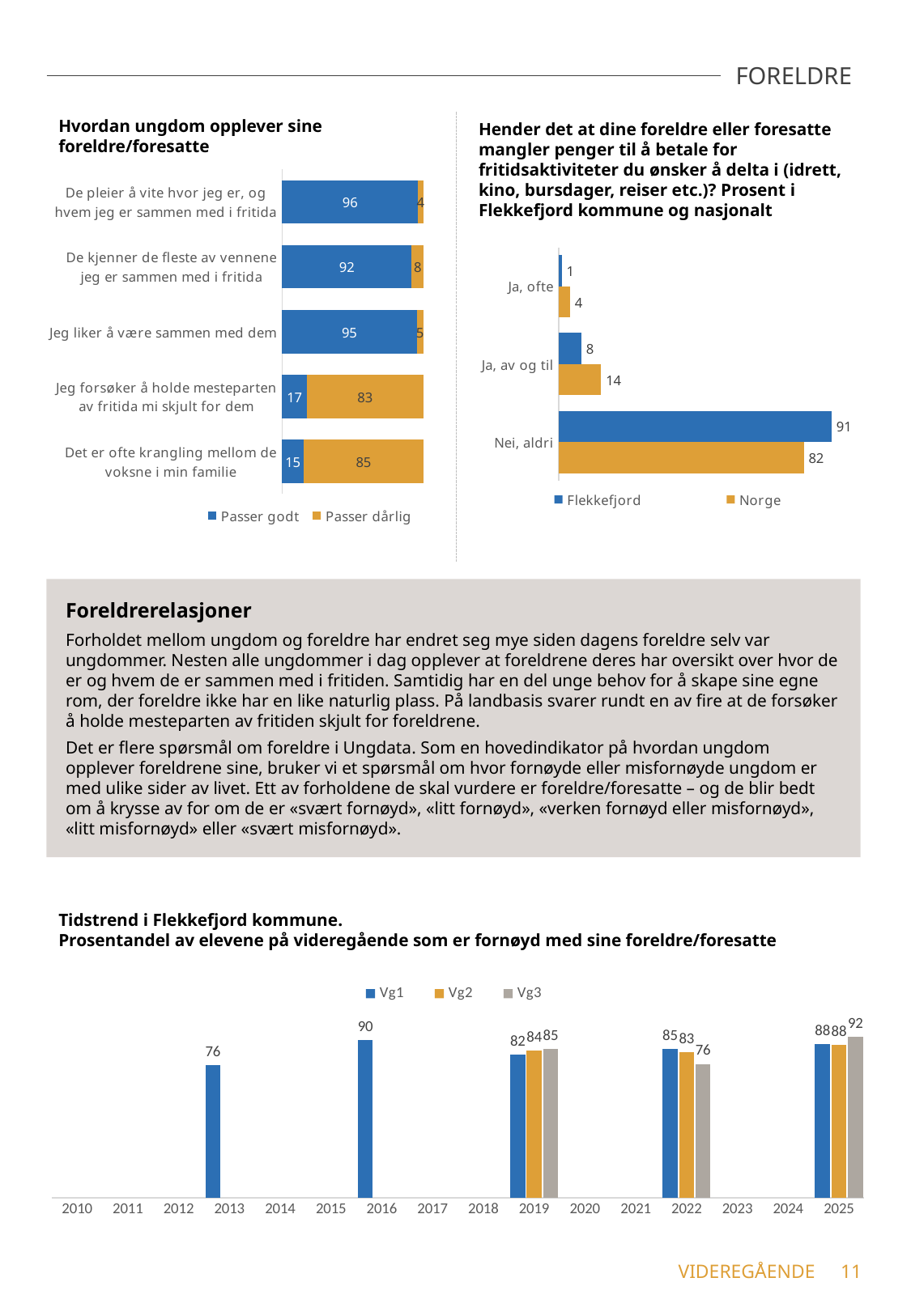
In the top-right chart about parents lacking money for leisure activities, what is the difference between Flekkefjord and Norge for 'Nei, aldri'? 9 In the chart 'Hvordan ungdom opplever sine foreldre/foresatte', what is the 'Passer godt' value for 'De pleier å vite hvor jeg er, og hvem jeg er sammen med i fritida'? 96 In the chart 'Tidstrend i Flekkefjord kommune', what is the difference between the Vg1 values for 2013 and 2016? 14 In the chart 'Hvordan ungdom opplever sine foreldre/foresatte', what is the 'Passer dårlig' value for 'Det er ofte krangling mellom de voksne i min familie'? 85 In the top-right chart about parents lacking money for leisure activities, how many series does the legend list? 2 In the chart 'Tidstrend i Flekkefjord kommune', what is the Vg1 value for 2016? 90 What kind of chart is 'Tidstrend i Flekkefjord kommune'? Bar chart In the top-right chart about parents lacking money for leisure activities, which is larger for 'Ja, ofte': Flekkefjord or Norge? Norge In the chart 'Hvordan ungdom opplever sine foreldre/foresatte', which statement has the lowest 'Passer godt' value? Det er ofte krangling mellom de voksne i min familie In the top-right chart about parents lacking money for leisure activities, what is the value for Norge in the 'Ja, av og til' category? 14 In the chart 'Tidstrend i Flekkefjord kommune', what is the Vg3 value for 2025? 92 In the chart 'Hvordan ungdom opplever sine foreldre/foresatte', how many statements (categories) are shown? 5